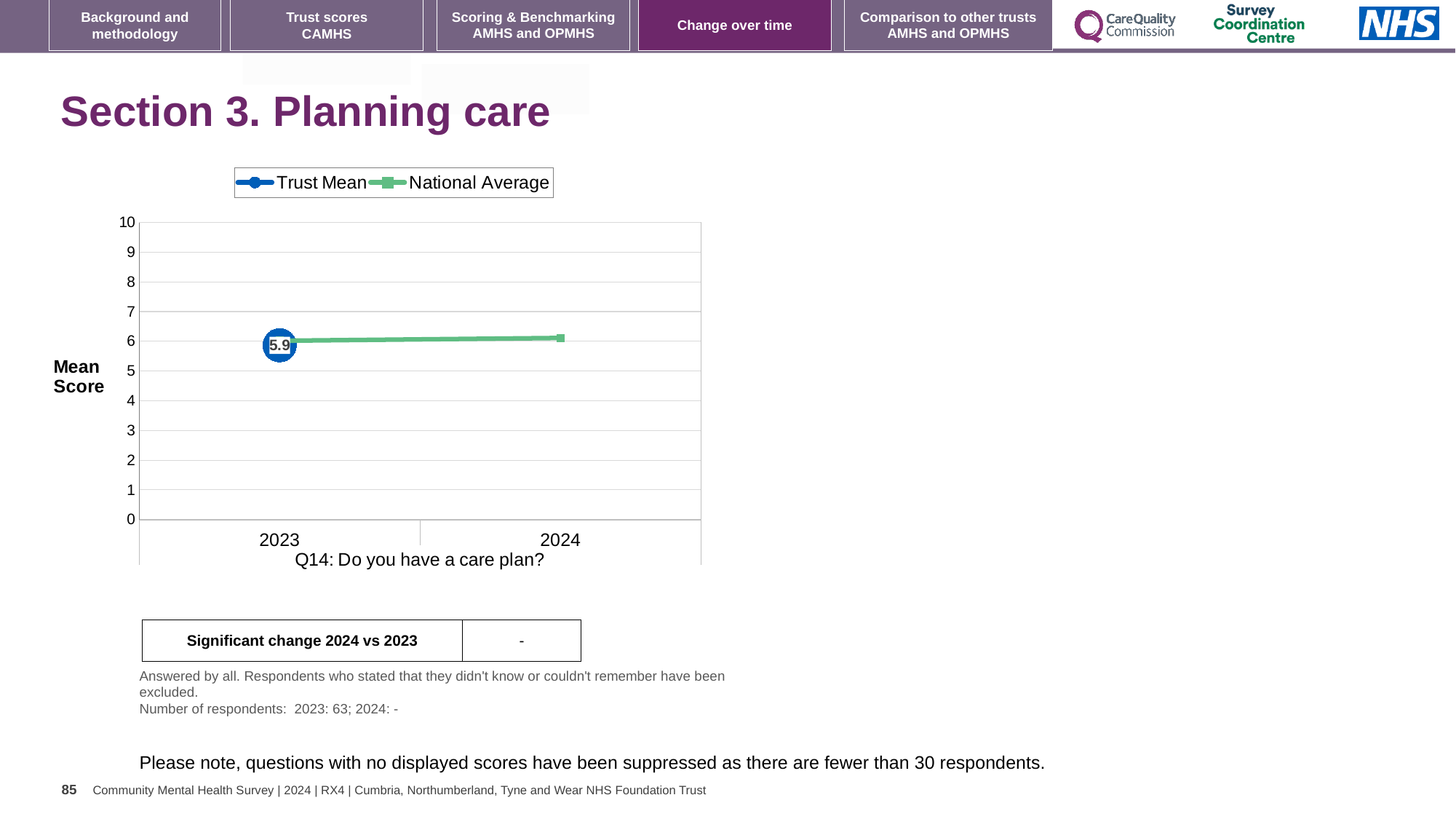
What are the two series named in the legend? Trust Mean and National Average Is the National Average value for 2024 greater or less than 7? less How many series does the legend list? 2 Is the Trust Mean value for 2023 greater or less than 8? less What is the maximum value shown on the y axis? 10 What kind of chart is shown on the slide? line chart Is the National Average value for 2023 greater or less than 5? greater How many years are shown on the x axis? 2 What is the Trust Mean value for 2023? 5.9 Which years are shown on the x axis? 2023 and 2024